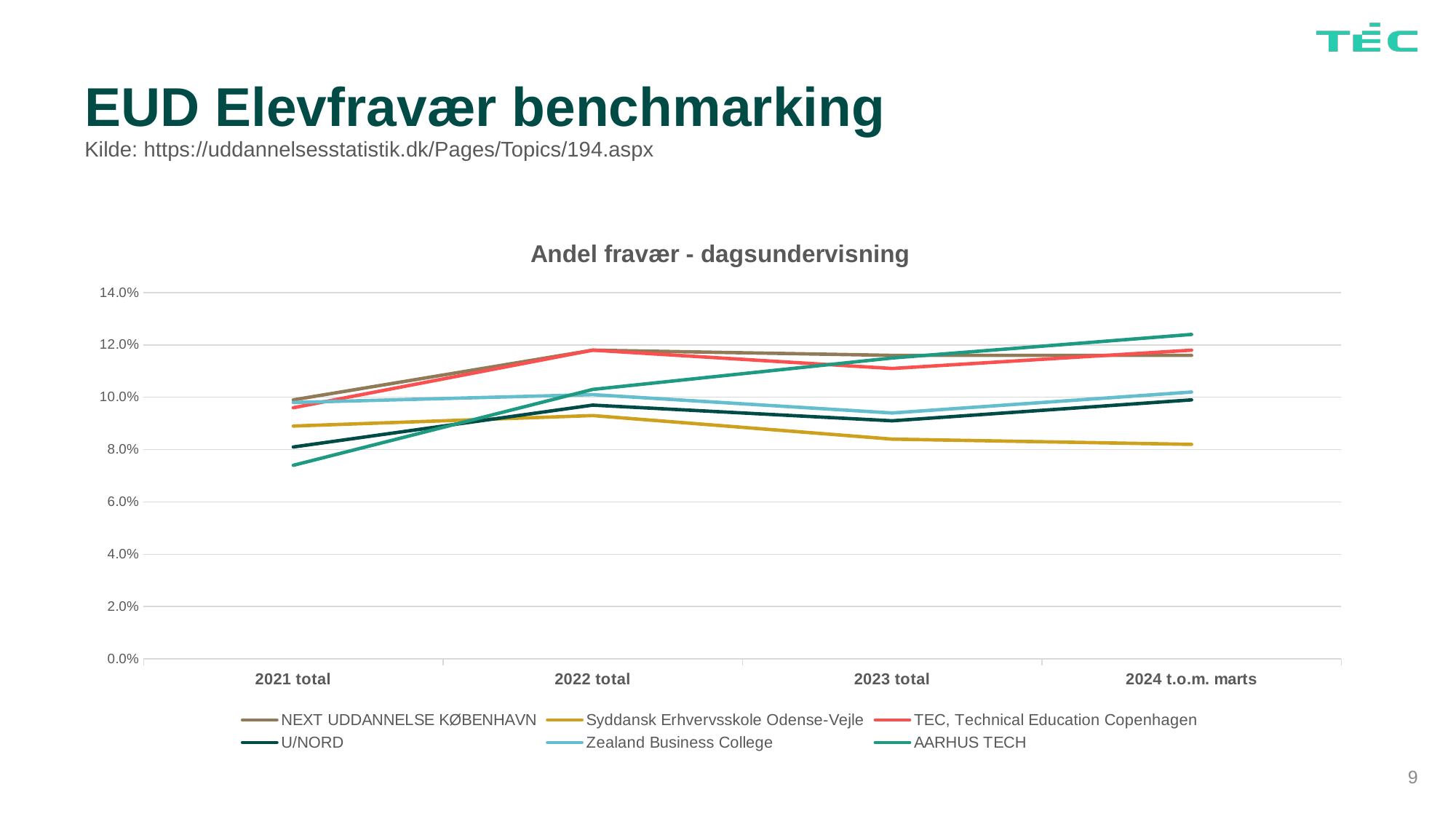
How many series does the legend list? 6 Which series has the lowest value at 2021 total? AARHUS TECH Is the value for Syddansk Erhvervsskole Odense-Vejle at 2024 t.o.m. marts greater or less than 10.0%? less Does the AARHUS TECH line rise or fall from 2021 total to 2024 t.o.m. marts? rise What kind of chart is shown on the slide? line chart Which series has the lowest value at 2024 t.o.m. marts? Syddansk Erhvervsskole Odense-Vejle Is the value for AARHUS TECH at 2024 t.o.m. marts greater or less than 12.0%? greater Which series has the highest value at 2024 t.o.m. marts? AARHUS TECH How many categories are shown along the x axis? 4 Is the value for U/NORD at 2021 total greater or less than 10.0%? less What is the title of the chart? Andel fravær - dagsundervisning At 2021 total, which is larger: NEXT UDDANNELSE KØBENHAVN or U/NORD? NEXT UDDANNELSE KØBENHAVN